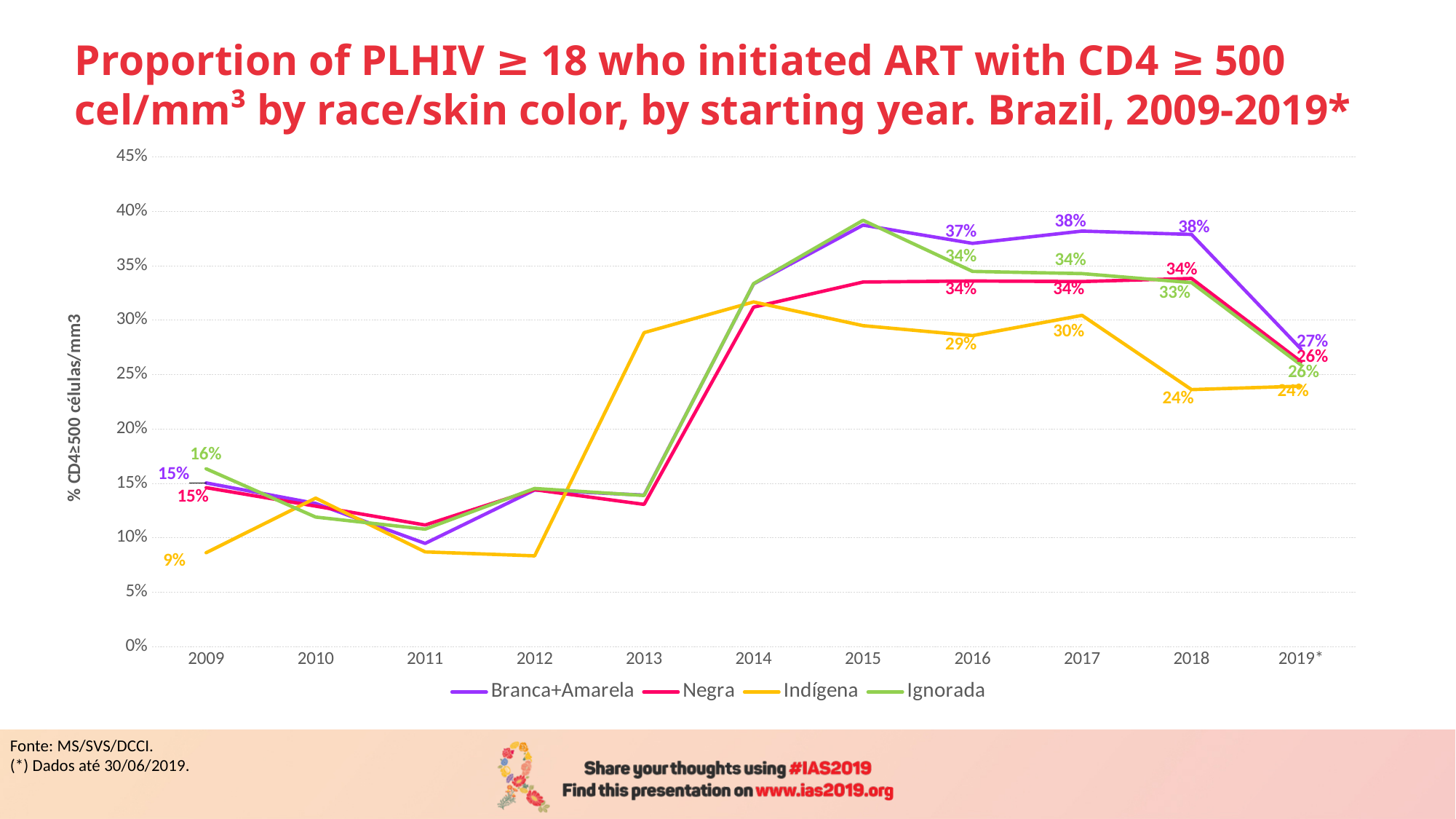
What kind of chart is shown on the slide? Line chart What is the value for Indígena in 2018? 24% What is the value for Indígena in 2009? 9% How many series does the legend list? 4 Which series has the lowest value in 2019*? Indígena What is the value for Ignorada in 2019*? 26% In 2018, which is larger: Negra or Ignorada? Negra Which series has the highest value in 2017? Branca+Amarela How many years are shown on the x axis? 11 Is the value for Indígena in 2013 greater or less than 25%? greater What is the value for Branca+Amarela in 2017? 38% What is the difference between Branca+Amarela and Indígena in 2016? 8 percentage points